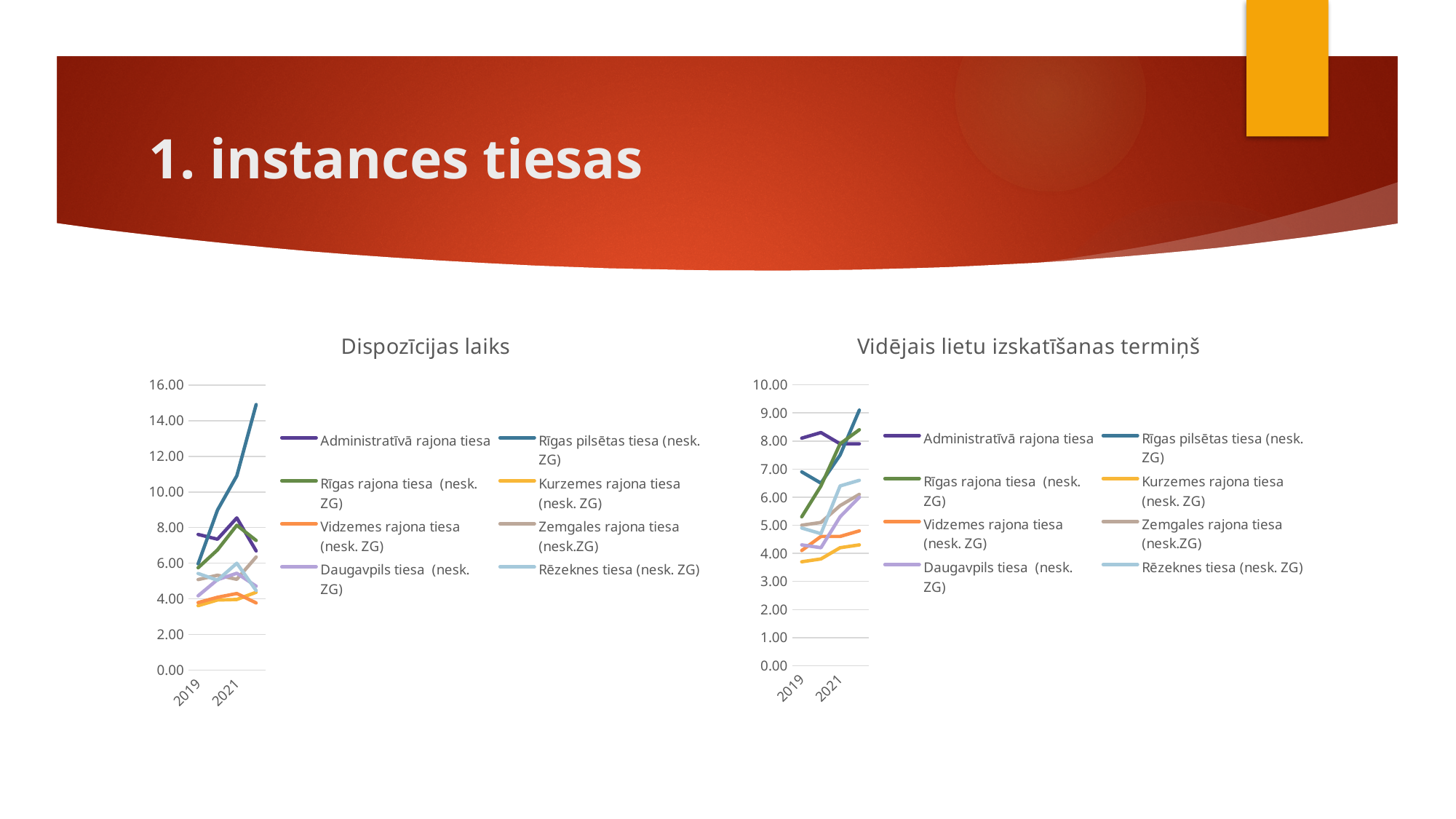
In the left chart "Dispozīcijas laiks", how many series does the legend list? 8 What kind of chart is the right chart titled "Vidējais lietu izskatīšanas termiņš"? line chart What kind of chart is the left chart titled "Dispozīcijas laiks"? line chart In the right chart "Vidējais lietu izskatīšanas termiņš", is the value for Administratīvā rajona tiesa in 2019 greater or less than 7.00? greater In the right chart "Vidējais lietu izskatīšanas termiņš", how many series does the legend list? 8 In the left chart "Dispozīcijas laiks", which series reaches the highest value? Rīgas pilsētas tiesa (nesk. ZG) What is the title of the chart on the right side of the slide? Vidējais lietu izskatīšanas termiņš In the left chart "Dispozīcijas laiks", does the line for Rīgas pilsētas tiesa (nesk. ZG) rise or fall from 2019 onward? rises In the left chart "Dispozīcijas laiks", is the final value for Rīgas pilsētas tiesa (nesk. ZG) greater or less than 14.00? greater In the right chart "Vidējais lietu izskatīšanas termiņš", which series has the larger final value: Rīgas pilsētas tiesa (nesk. ZG) or Kurzemes rajona tiesa (nesk. ZG)? Rīgas pilsētas tiesa (nesk. ZG) In the right chart "Vidējais lietu izskatīšanas termiņš", is the value for Kurzemes rajona tiesa (nesk. ZG) in 2019 greater or less than 5.00? less What is the title of the chart on the left side of the slide? Dispozīcijas laiks